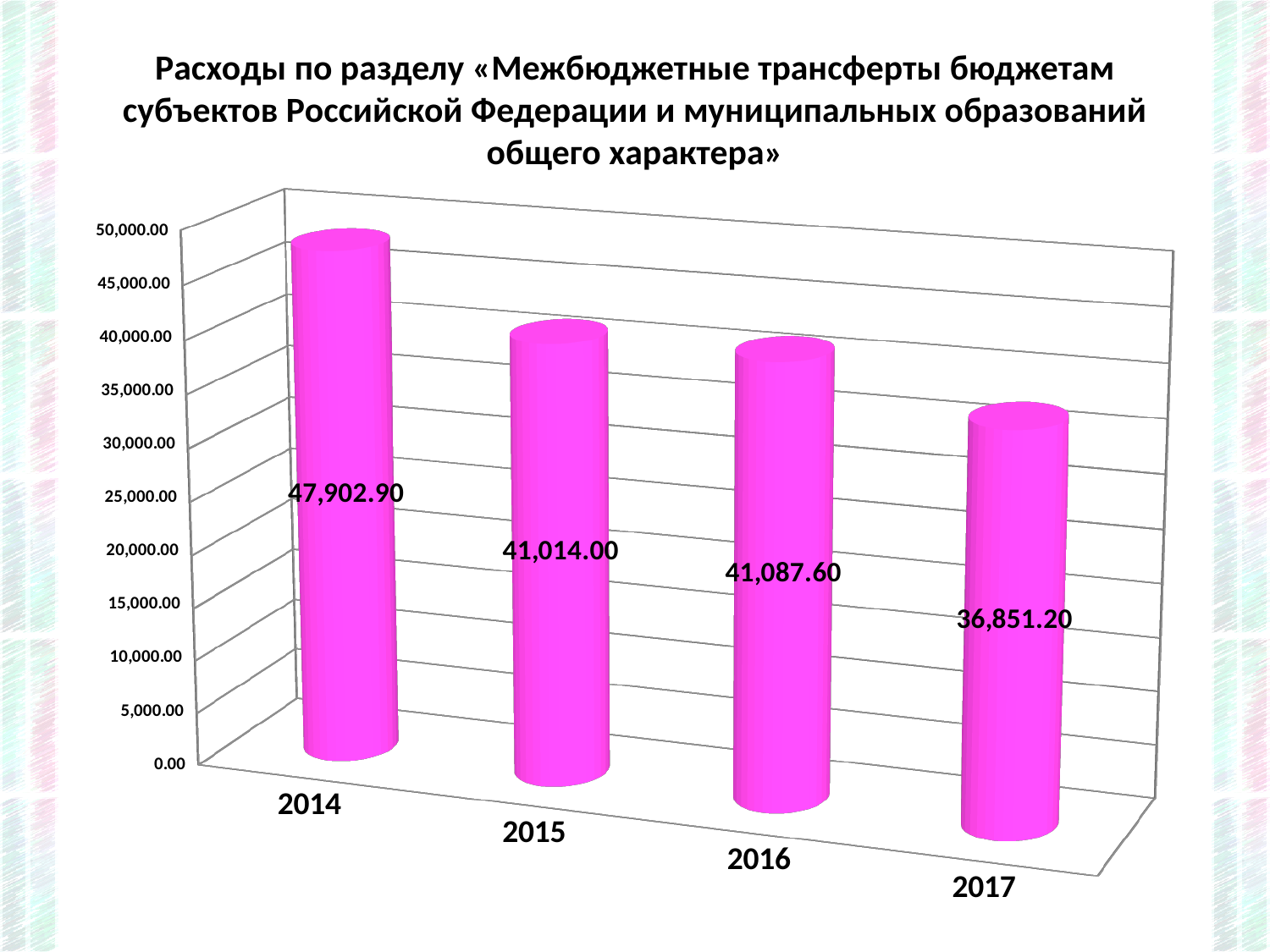
Which year has the lowest value? 2017 What is the value for 2014? 47,902.90 Which year has the highest value? 2014 What is the difference between the values for 2016 and 2015? 73.60 What kind of chart is shown on the slide? bar chart Is the value for 2017 greater or less than 40,000.00? less Which is larger, the value for 2014 or the value for 2015? 2014 How many years are shown on the chart? 4 Overall, do the values rise or fall from 2014 to 2017? fall What is the value for 2015? 41,014.00 What is the difference between the values for 2014 and 2017? 11,051.70 What is the value for 2017? 36,851.20